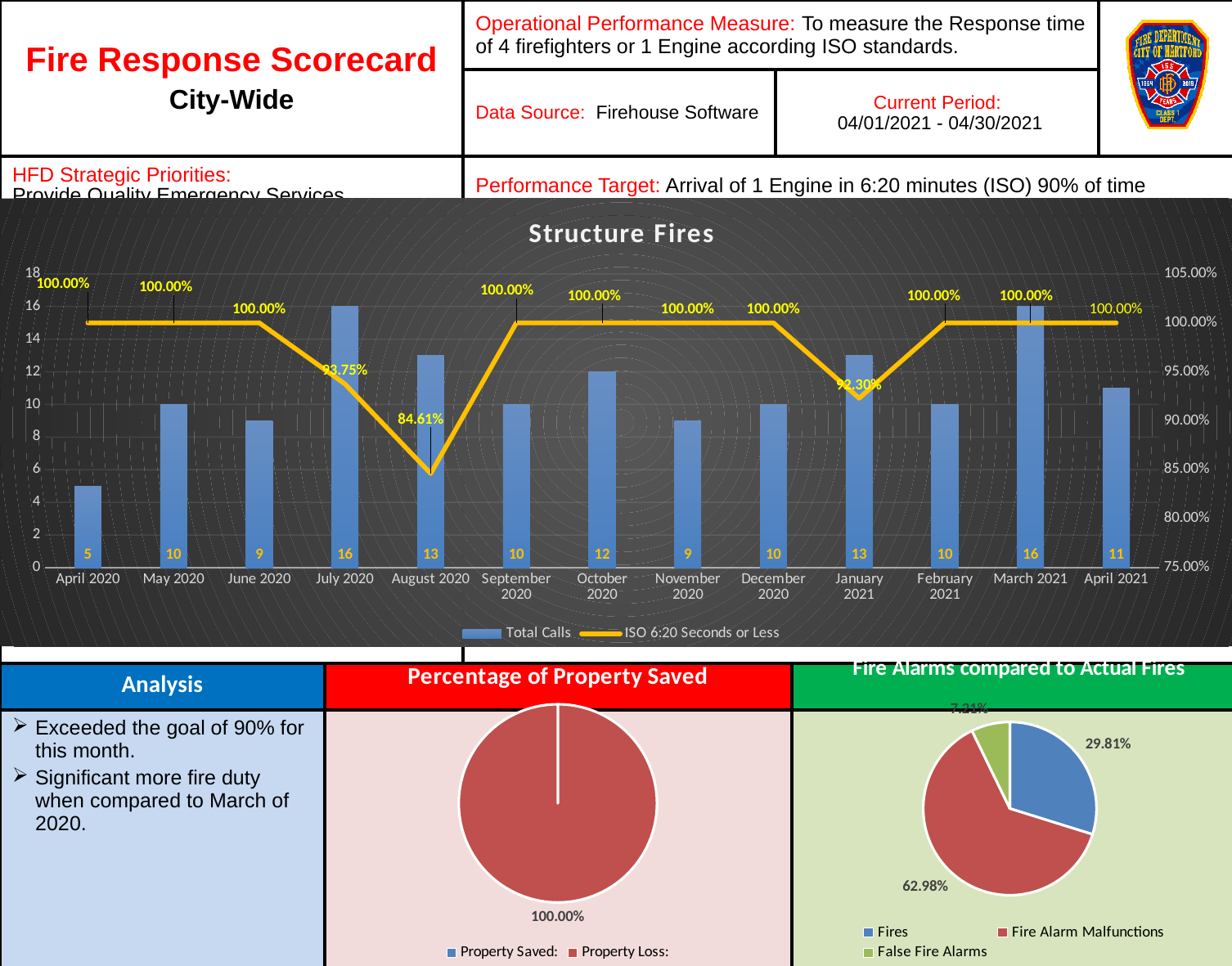
In the Structure Fires chart, which month had more total calls, October 2020 or November 2020? October 2020 In the Structure Fires chart, how many total calls were there in July 2020? 16 In the Structure Fires chart, which month has the lowest ISO 6:20 Seconds or Less percentage? August 2020 In the Structure Fires chart, what is the ISO 6:20 Seconds or Less percentage for August 2020? 84.61% How many series does the legend of the Structure Fires chart list? 2 In the Structure Fires chart, what is the ISO 6:20 Seconds or Less percentage for January 2021? 92.30% In the Structure Fires chart, which month has the lowest number of total calls? April 2020 In the Fire Alarms compared to Actual Fires chart, what share of the pie is Fires? 29.81% What kind of chart is the Percentage of Property Saved chart? Pie chart How many months are shown on the x axis of the Structure Fires chart? 13 In the Fire Alarms compared to Actual Fires chart, which category has the largest slice? Fire Alarm Malfunctions In the Structure Fires chart, what is the difference in total calls between March 2021 and April 2021? 5